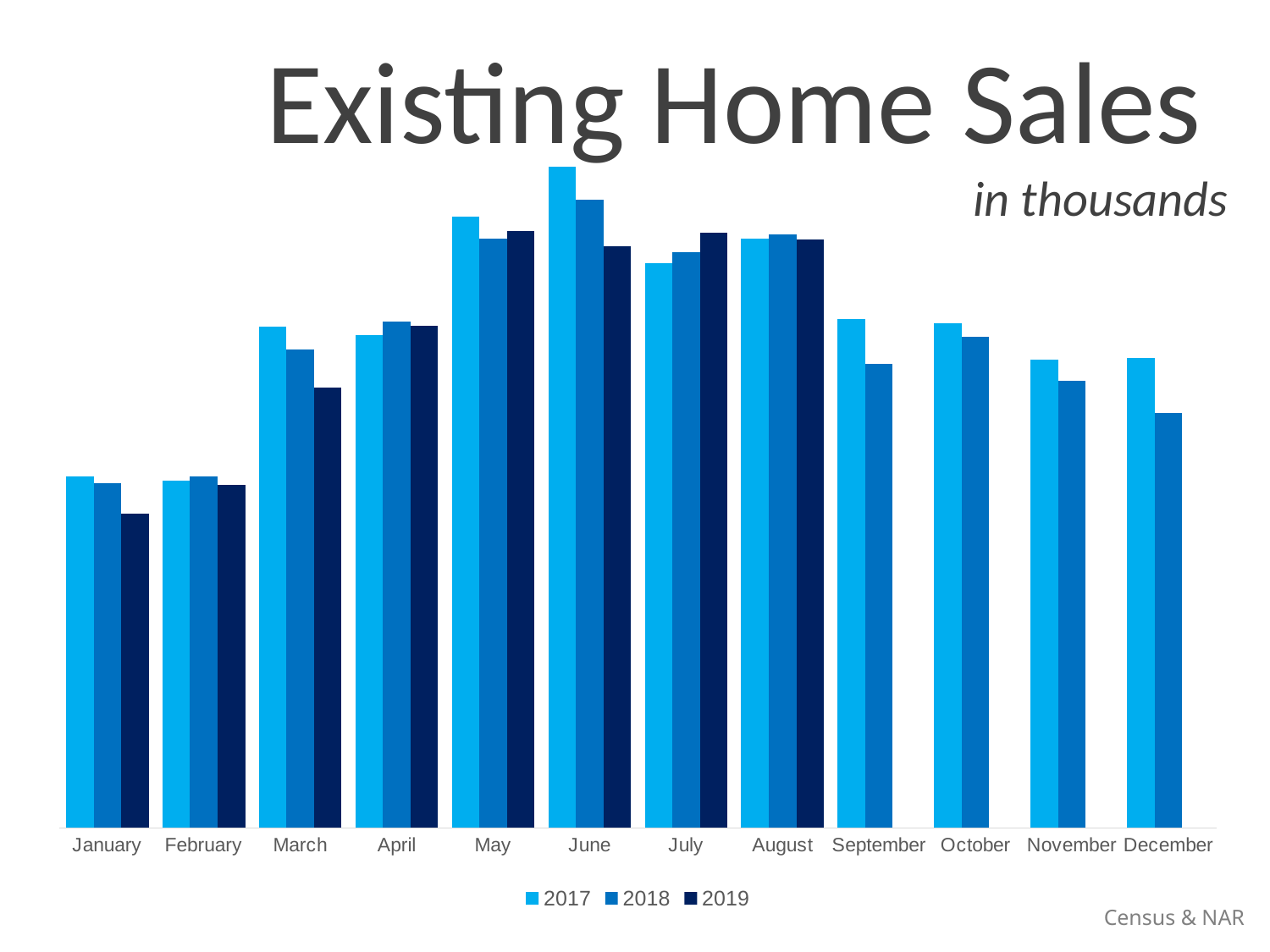
In what units are the values shown, according to the subtitle? in thousands Do the 2017 values rise or fall from August to December? fall For June, which is larger: the 2017 value or the 2019 value? 2017 In which month is the 2017 bar the highest? June What kind of chart is shown on the slide? bar chart In which month is the 2018 bar the highest? June For December, which is larger: the 2017 value or the 2018 value? 2017 For March, which is larger: the 2018 value or the 2019 value? 2018 How many months are shown along the x axis? 12 How many series does the legend list? 3 In which month is the 2019 bar the lowest? January Which years are listed in the legend? 2017, 2018, 2019